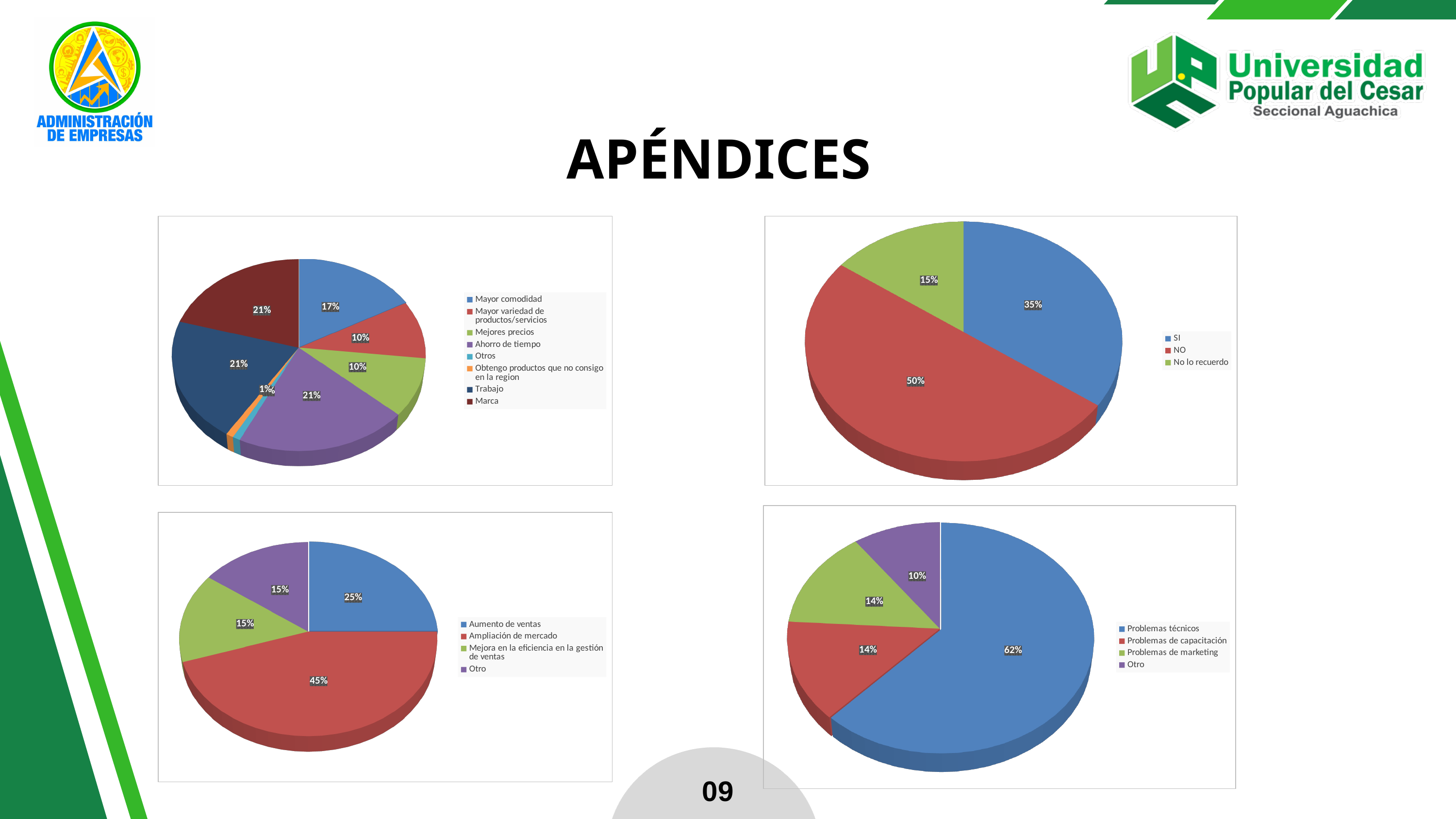
In the bottom-right pie chart, what percentage is shown for Problemas técnicos? 62% How many categories does the legend of the top-right pie chart list? 3 In the bottom-right pie chart, which is larger: Problemas técnicos or Problemas de marketing? Problemas técnicos In the bottom-right pie chart, which category has the smallest share? Otro In the top-right pie chart, what percentage is shown for NO? 50% In the bottom-left pie chart, what is the difference between Ampliación de mercado and Aumento de ventas? 20% What type of chart is the top-left chart? Pie chart In the bottom-left pie chart, what percentage is shown for Ampliación de mercado? 45% In the top-left pie chart, what percentage is shown for Mayor comodidad? 17% In the bottom-left pie chart, which category has the largest share? Ampliación de mercado In the top-right pie chart, which category has the smallest share? No lo recuerdo In the top-right pie chart, what is the difference between the SI and NO shares? 15%